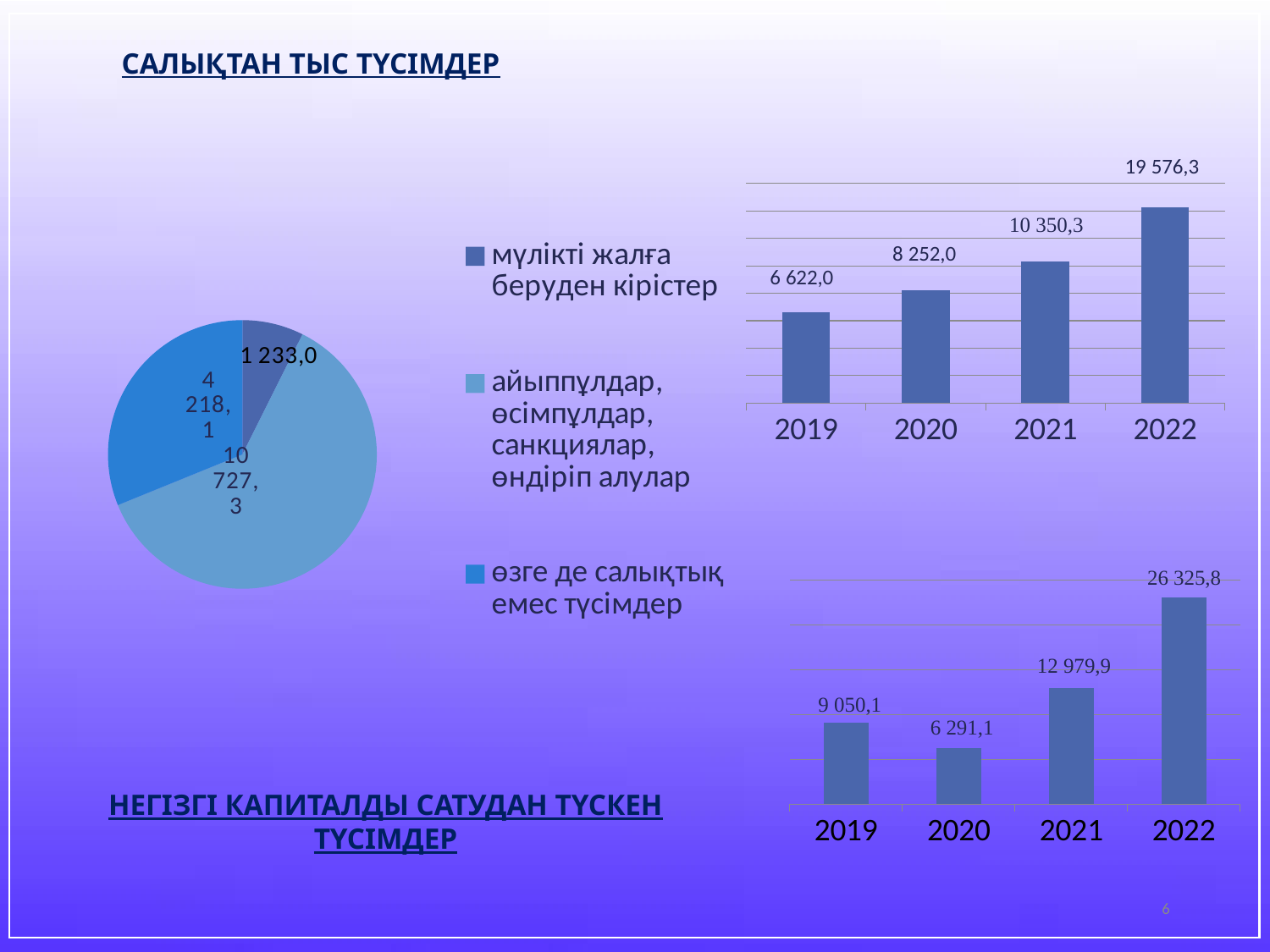
In the top-right bar chart, what is the value for 2022? 19 576,3 In the pie chart on the left, which category has the smallest slice? мүлікті жалға беруден кірістер In the top-right bar chart, what is the difference between the 2022 and 2021 values? 9 226,0 In the top-right bar chart, what is the value for 2019? 6 622,0 In the pie chart on the left, what is the value for айыппұлдар, өсімпұлдар, санкциялар, өндіріп алулар? 10 727,3 In the bottom-right bar chart (НЕГІЗГІ КАПИТАЛДЫ САТУДАН ТҮСКЕН ТҮСІМДЕР), how many years are shown? 4 In the top-right bar chart, do the values rise or fall from 2019 to 2022? rise In the bottom-right bar chart (НЕГІЗГІ КАПИТАЛДЫ САТУДАН ТҮСКЕН ТҮСІМДЕР), which year has the highest value? 2022 What kind of chart is the chart on the left of the slide? pie chart In the bottom-right bar chart (НЕГІЗГІ КАПИТАЛДЫ САТУДАН ТҮСКЕН ТҮСІМДЕР), which is larger, the value for 2019 or for 2020? 2019 In the top-right bar chart, which year has the lowest value? 2019 In the bottom-right bar chart (НЕГІЗГІ КАПИТАЛДЫ САТУДАН ТҮСКЕН ТҮСІМДЕР), what is the value for 2020? 6 291,1